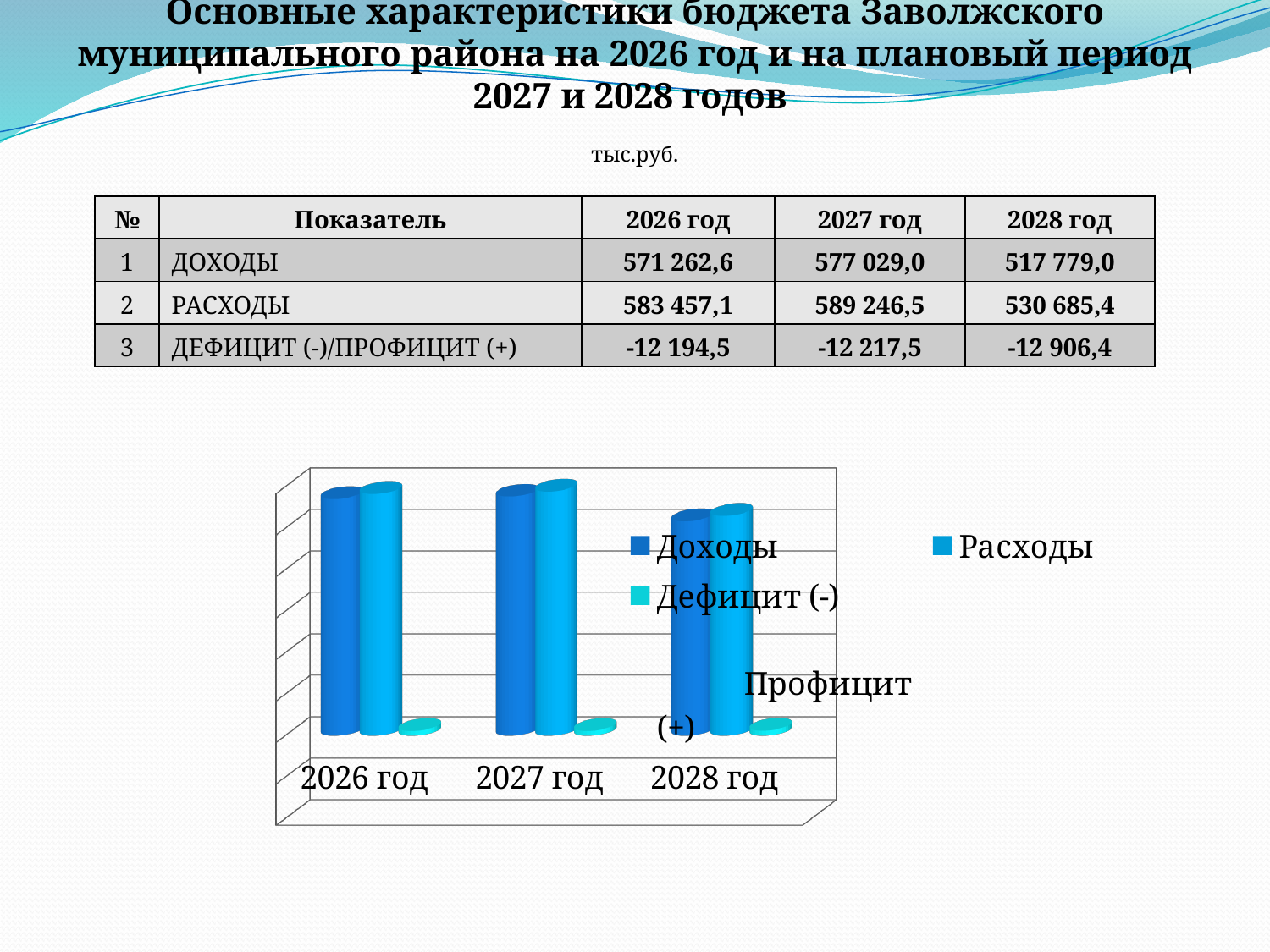
Is the Доходы bar for 2027 год taller or shorter than the Доходы bar for 2028 год? taller According to the table on the slide, what is the value of Расходы for 2028 год? 530 685,4 Using the table values, what is the difference between Расходы and Доходы for 2028 год? 12 906,4 According to the table on the slide, what is the value of Доходы for 2026 год? 571 262,6 How many year categories are shown along the x axis of the chart? 3 How many series does the chart legend list? 3 Which year has the lowest Доходы bar in the chart? 2028 год Which series is shown in the lightest (turquoise) colour in the chart? Дефицит (-)/Профицит (+) What kind of chart is shown on the slide? bar chart According to the table on the slide, what is the value of Дефицит (-)/Профицит (+) for 2027 год? -12 217,5 Which year has the highest Расходы bar in the chart? 2027 год Do the Расходы bars rise or fall from 2027 год to 2028 год? fall